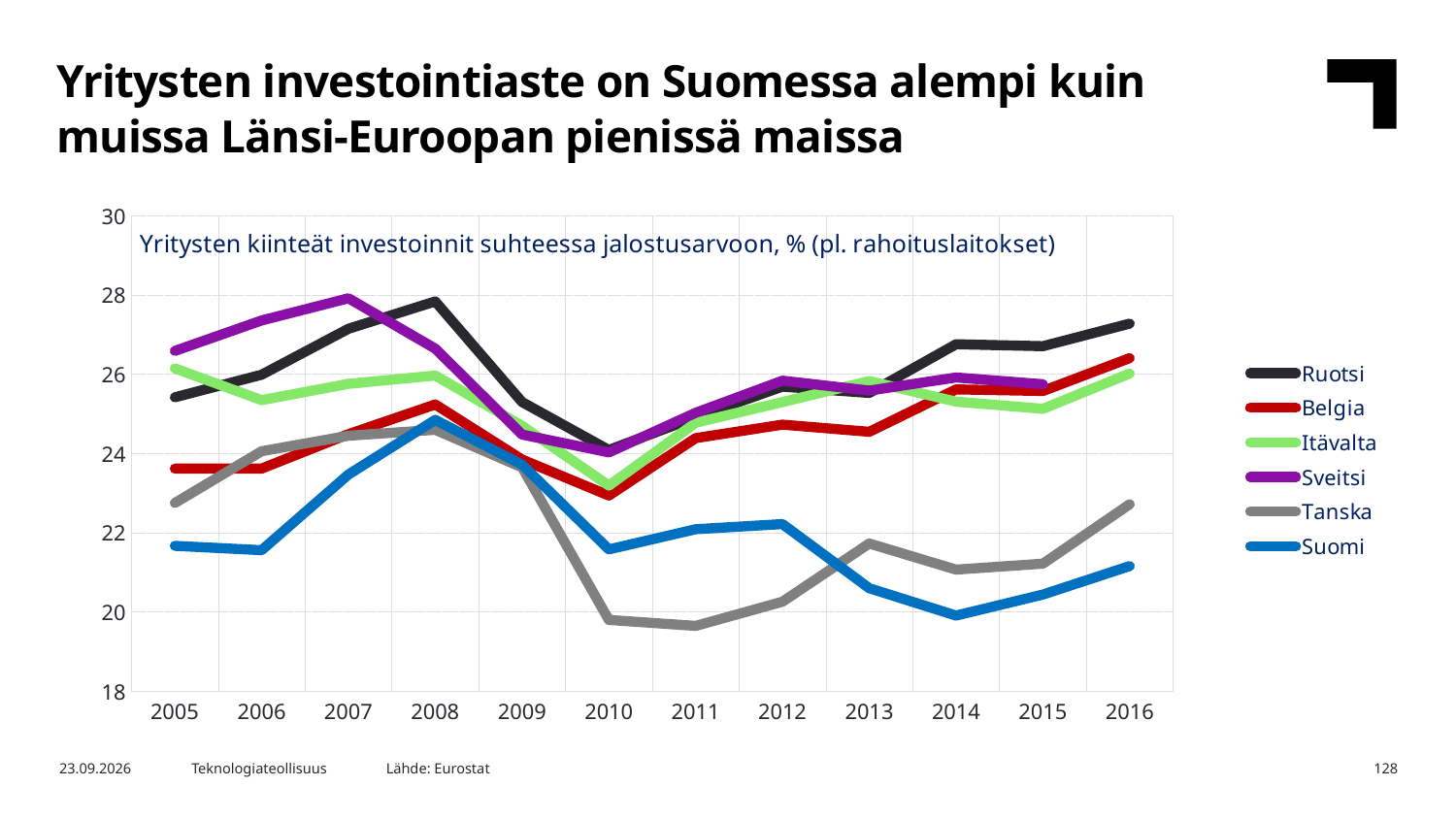
Is the value for Ruotsi in 2016 greater or less than 26? greater What kind of chart is shown on the slide? line chart How many years are shown on the x axis? 12 In 2013, which is larger, the value for Tanska or the value for Suomi? Tanska What colour is the line for Suomi? blue How many series does the legend list? 6 Does the value for Suomi rise or fall from 2012 to 2014? fall Which country has the highest value in 2008? Ruotsi Is the value for Tanska in 2011 greater or less than 20? less Which country has the lowest value in 2016? Suomi In which year does Ruotsi reach its highest value? 2008 Which country has the highest value in 2007? Sveitsi